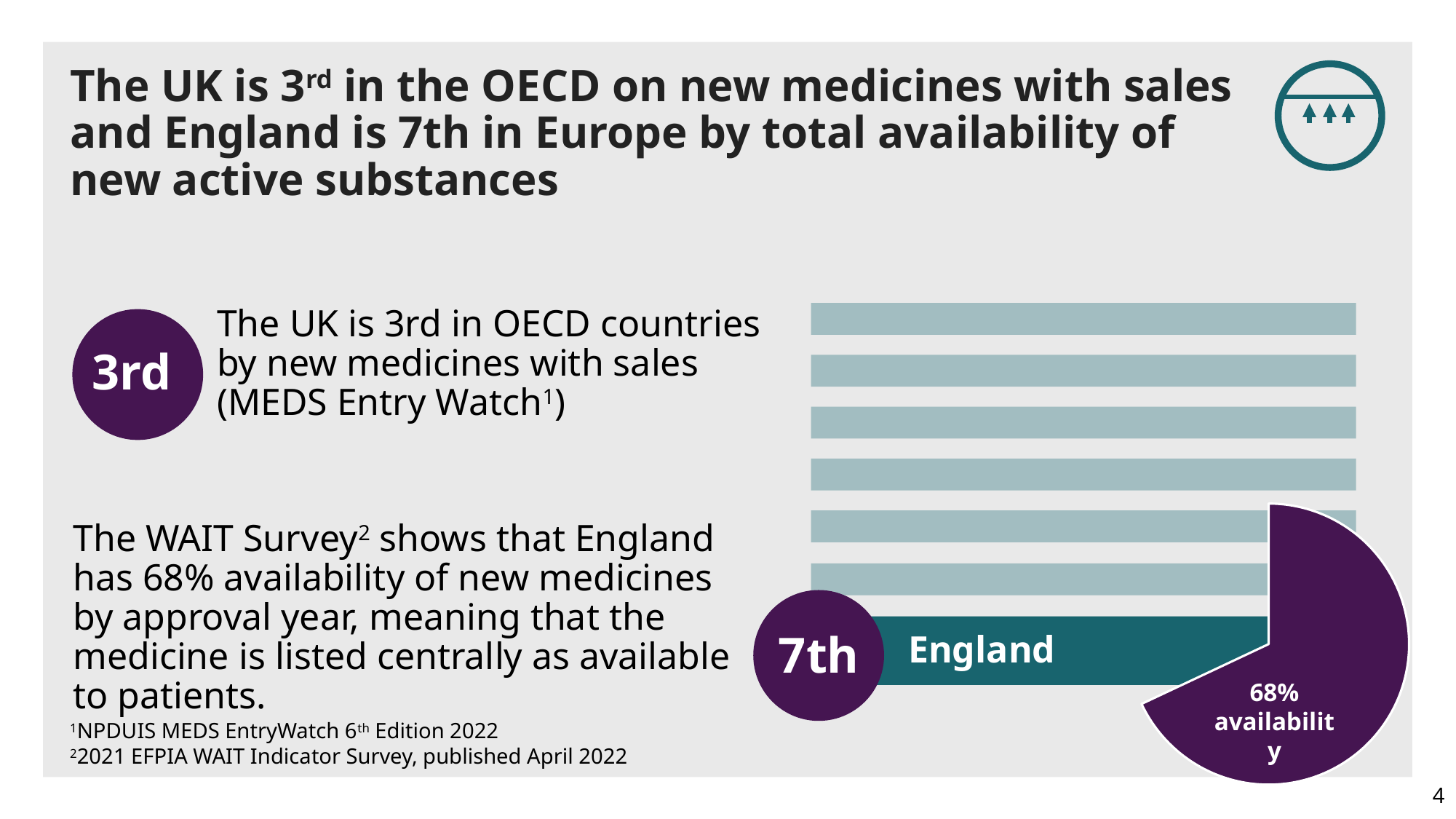
How many horizontal bars are shown in the bar graphic on the right of the slide? 7 What kind of chart is the graphic of horizontal bars on the right of the slide? bar chart In the bar graphic on the right, what rank is shown in the circle next to the England bar? 7th What rank is shown in the purple circle on the left of the slide for the UK in OECD countries by new medicines with sales? 3rd In the bar graphic on the right, is the England bar at the top or the bottom of the list of bars? bottom In the pie chart at the bottom right, what share does the highlighted slice represent? 68% availability What kind of chart is shown at the bottom right of the slide, labelled with 68% availability? pie chart In the bar graphic on the right, which bar is labelled with a country name? England